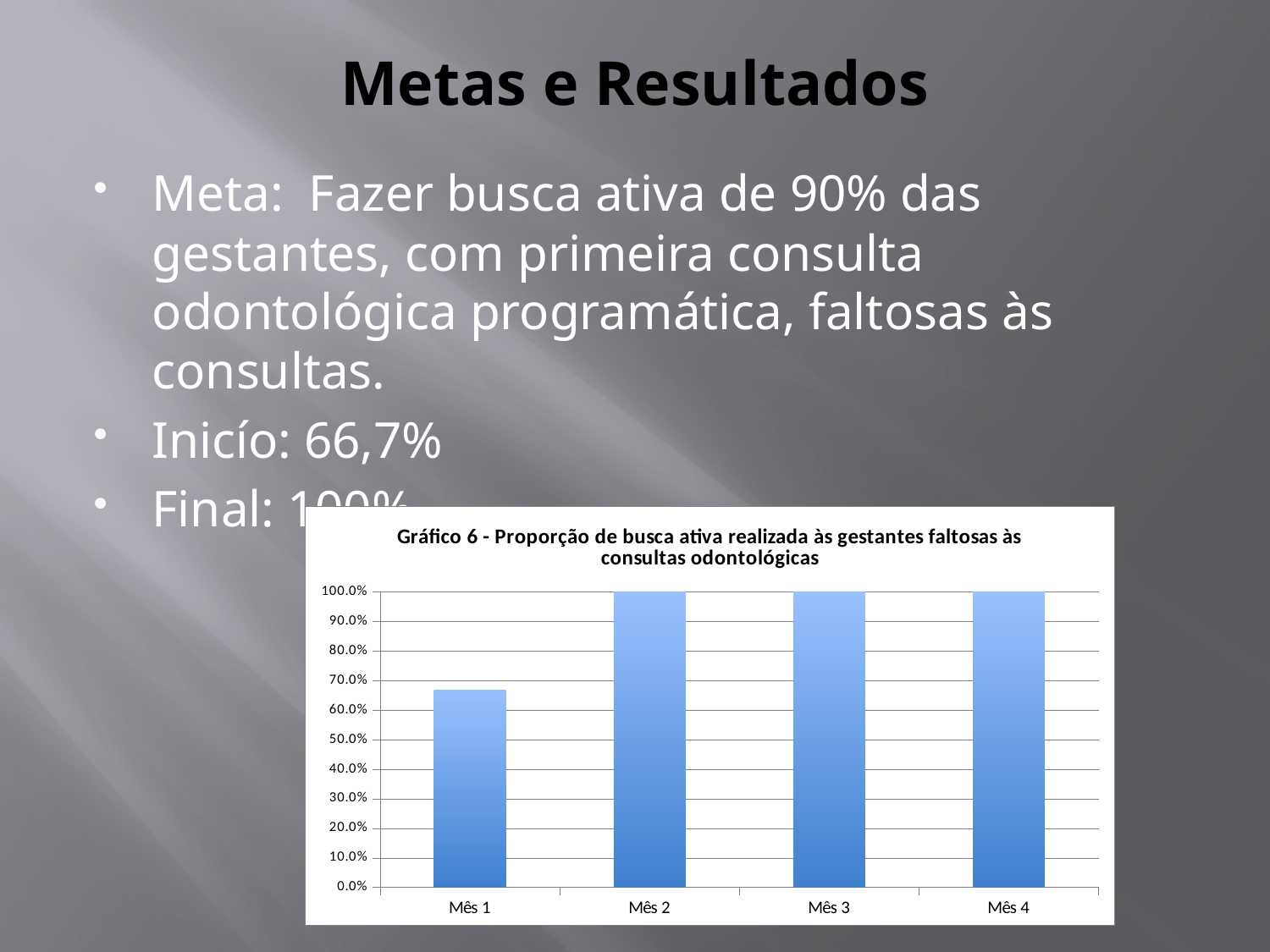
What is the value for Mês 3? 100.0% Does the value rise or fall from Mês 1 to Mês 2? rise Which is larger, the value for Mês 1 or the value for Mês 2? Mês 2 What kind of chart is shown on the slide? bar chart Is the value for Mês 1 greater or less than 70.0%? less What is the value for Mês 4? 100.0% What is the value for Mês 2? 100.0% Is the value for Mês 1 greater or less than 60.0%? greater How many months (categories) are plotted in the chart? 4 Which month has the lowest value? Mês 1 What is the title of the chart? Gráfico 6 - Proporção de busca ativa realizada às gestantes faltosas às consultas odontológicas What is the difference between the values for Mês 2 and Mês 4? 0.0%